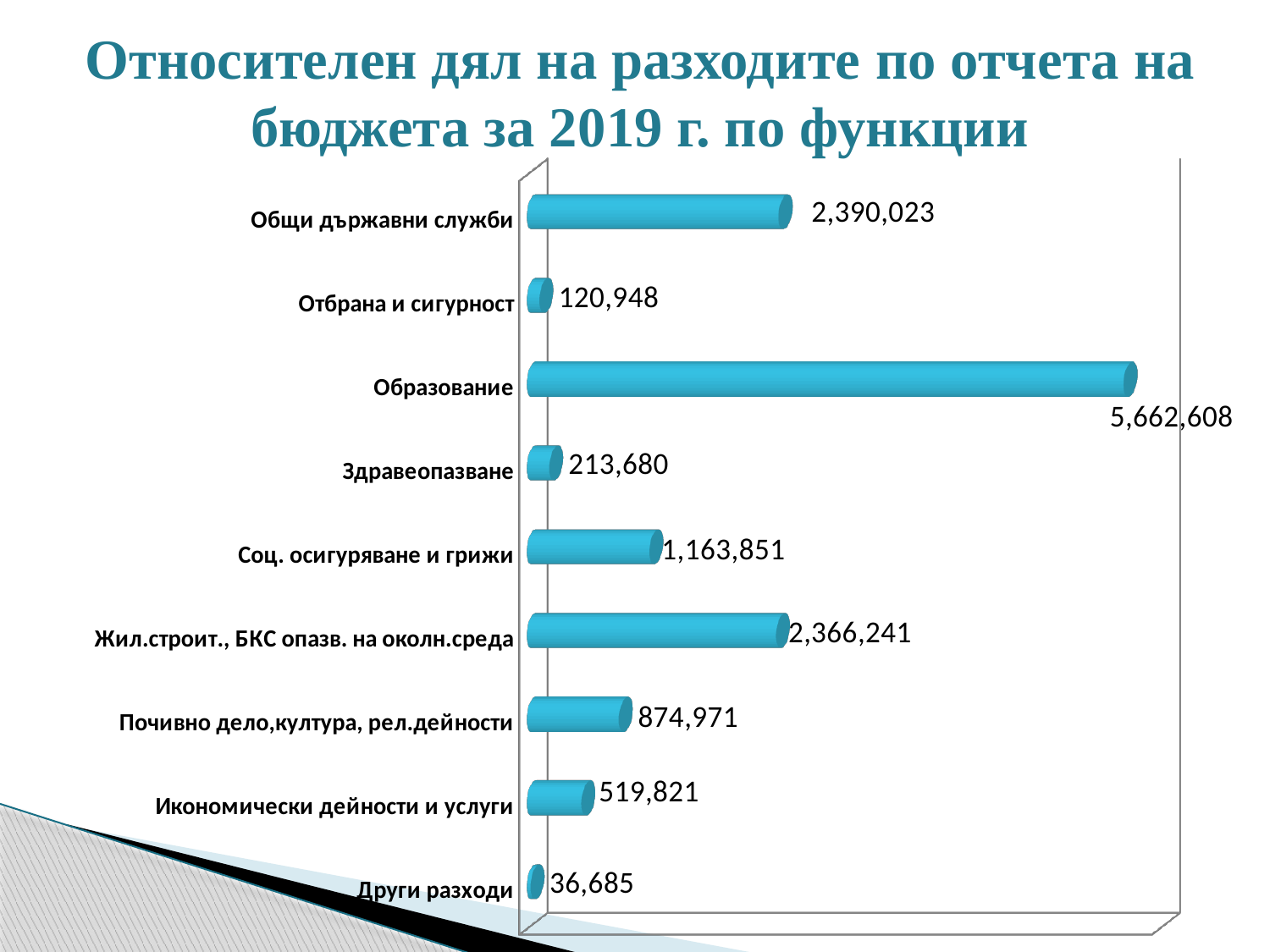
What is the value for Други разходи? 36,685 What is the difference between the values for Образование and Общи държавни служби? 3,272,585 What is the value for Образование? 5,662,608 Which category has the highest value? Образование What is the value for Отбрана и сигурност? 120,948 How many categories are shown in the chart? 9 Which is larger, the value for Общи държавни служби or the value for Жил.строит., БКС опазв. на околн.среда? Общи държавни служби What is the value for Соц. осигуряване и грижи? 1,163,851 Which category has the lowest value? Други разходи What kind of chart is shown on the slide? Bar chart What is the difference between the values for Здравеопазване and Отбрана и сигурност? 92,732 What is the value for Почивно дело,култура, рел.дейности? 874,971